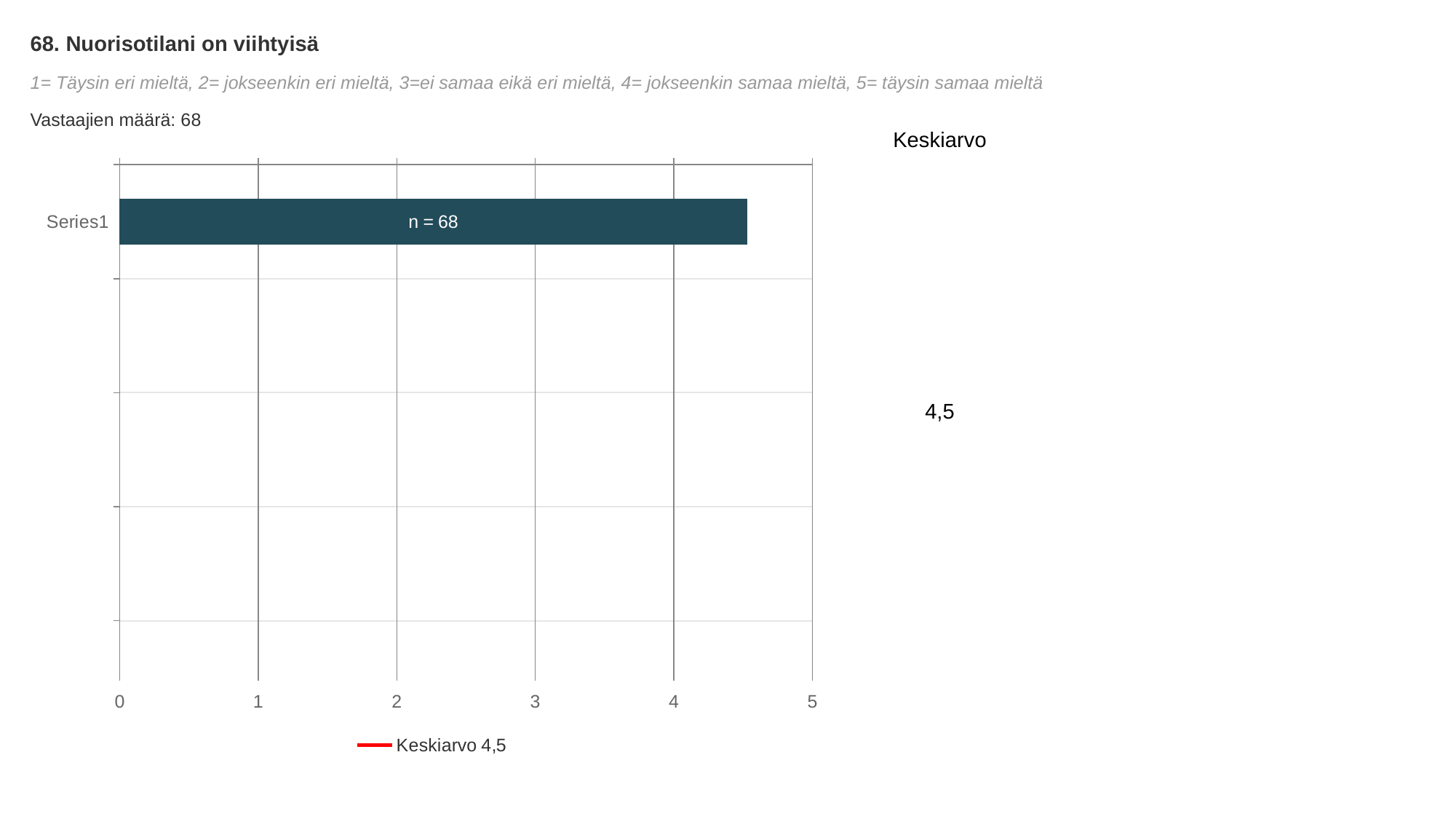
Is the value of the Series1 bar greater or less than 5? less How many bars are plotted in the chart? 1 What is the title of the chart? 68. Nuorisotilani on viihtyisä What is the Keskiarvo (mean) value shown on the slide? 4,5 What kind of chart is shown on the slide? bar chart What is the number of respondents (Vastaajien määrä) stated on the slide? 68 Is the value of the Series1 bar greater or less than 4? greater Is the value of the Series1 bar greater or less than 3? greater What is the highest value shown on the x axis? 5 What is the label of the category on the y axis? Series1 What data label is printed on the Series1 bar? n = 68